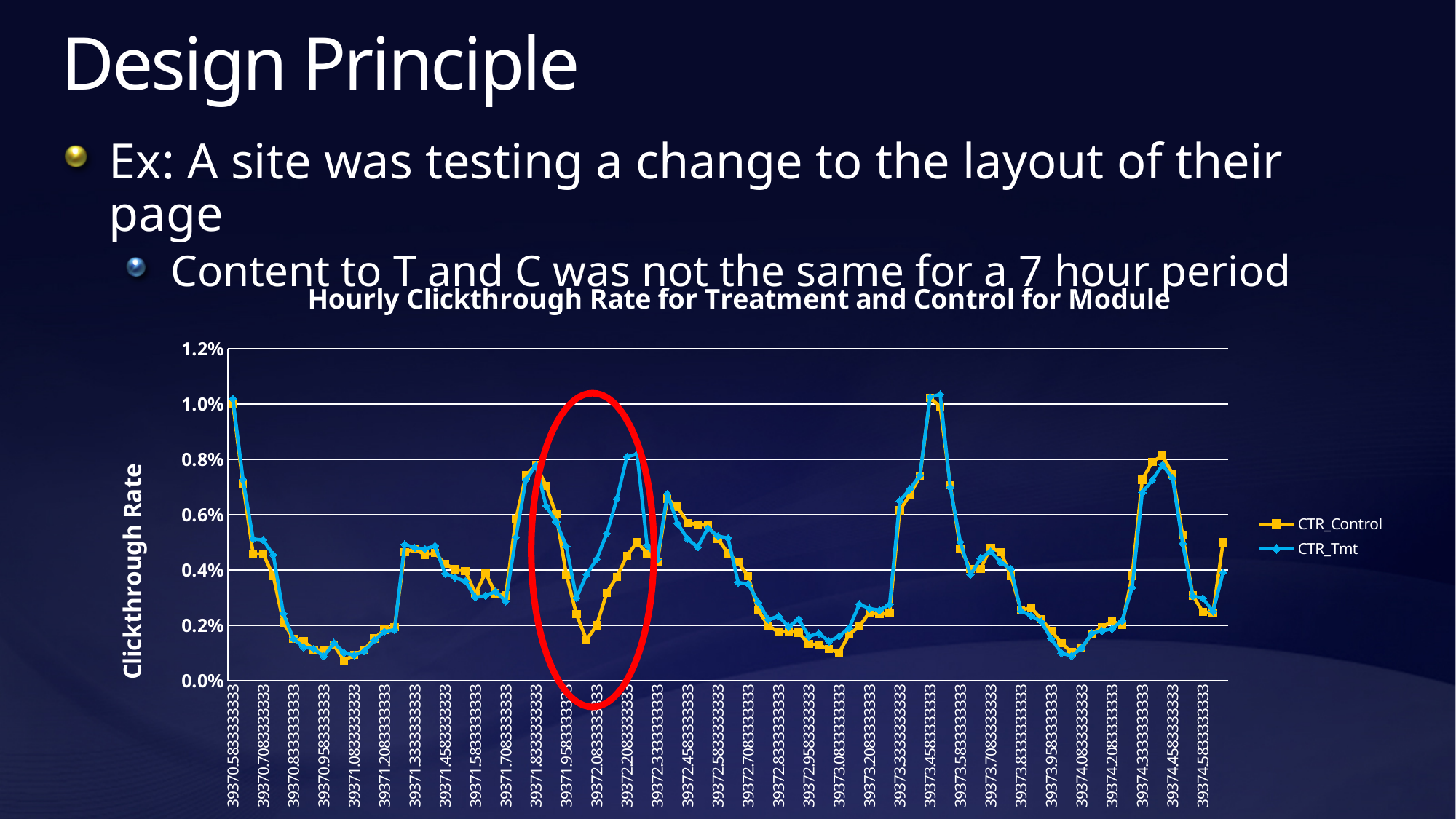
Is the value for CTR_Control at 39370.9583333333 greater or less than 0.2%? less Do the values for CTR_Control rise or fall between 39373.2083333333 and 39373.4583333333? rise Do the values for CTR_Tmt rise or fall between 39370.5833333333 and 39370.8333333333? fall How many series does the chart's legend list? 2 At 39372.2083333333, which series has the larger value, CTR_Control or CTR_Tmt? CTR_Tmt What are the two series named in the chart's legend? CTR_Control and CTR_Tmt Is the value for CTR_Tmt at 39373.4583333333 greater or less than 0.8%? greater Is the value for CTR_Control at 39370.5833333333 greater or less than 0.8%? greater What kind of chart is shown on the slide? line chart At 39372.0833333333, which series has the larger value, CTR_Control or CTR_Tmt? CTR_Tmt What is the title of the chart? Hourly Clickthrough Rate for Treatment and Control for Module